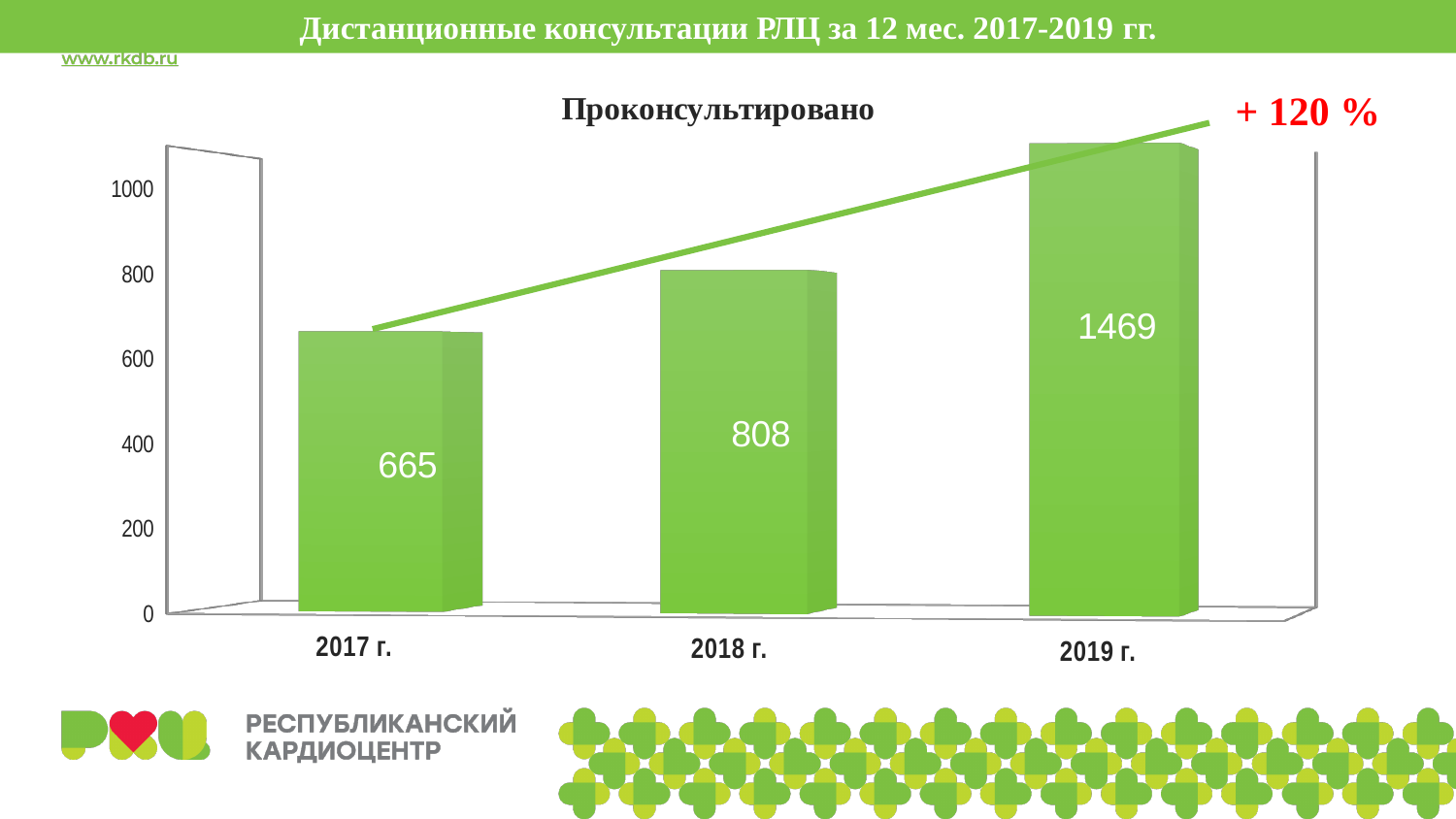
What is the value for 2017 г.? 665 How many years are shown on the chart? 3 Which year has the lowest value? 2017 г. What kind of chart is shown on the slide? bar chart What is the difference between the values for 2019 г. and 2017 г.? 804 Which year has the highest value? 2019 г. What is the value for 2019 г.? 1469 Do the values rise or fall from 2017 г. to 2019 г.? rise Is the value for 2019 г. greater or less than 1000? greater Which is larger, the value for 2018 г. or the value for 2017 г.? 2018 г. What is the difference between the values for 2018 г. and 2017 г.? 143 What is the value for 2018 г.? 808